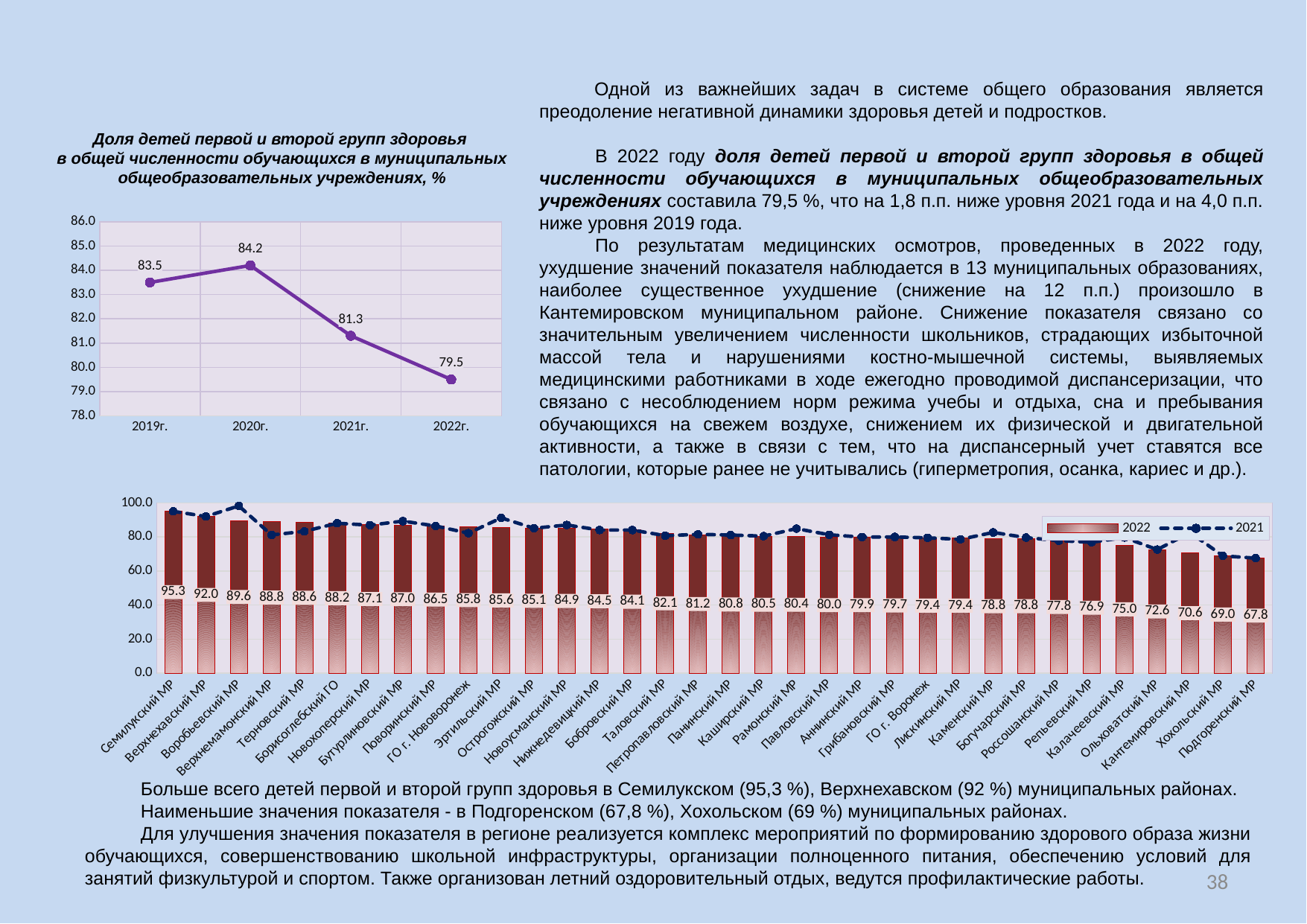
On the top-left line chart, which year has the lowest value? 2022г. On the bottom chart, what is the difference between the 2022 values for Семилукский МР and Подгоренский МР? 27.5 On the bottom chart, which municipality has the highest 2022 value? Семилукский МР On the top-left line chart, what is the difference between the 2019г. value and the 2022г. value? 4.0 On the bottom chart, what is the 2022 value for Семилукский МР? 95.3 On the bottom chart, is the 2021 value for Семилукский МР greater or less than 80.0? greater On the top-left line chart, what is the value for 2020г.? 84.2 On the bottom chart, which municipality has the lowest 2022 value? Подгоренский МР On the top-left line chart, how many data points are plotted? 4 On the top-left line chart, do the values rise or fall from 2020г. to 2022г.? fall On the bottom chart, how many series does the legend list? 2 On the top-left line chart, which year has the highest value? 2020г.